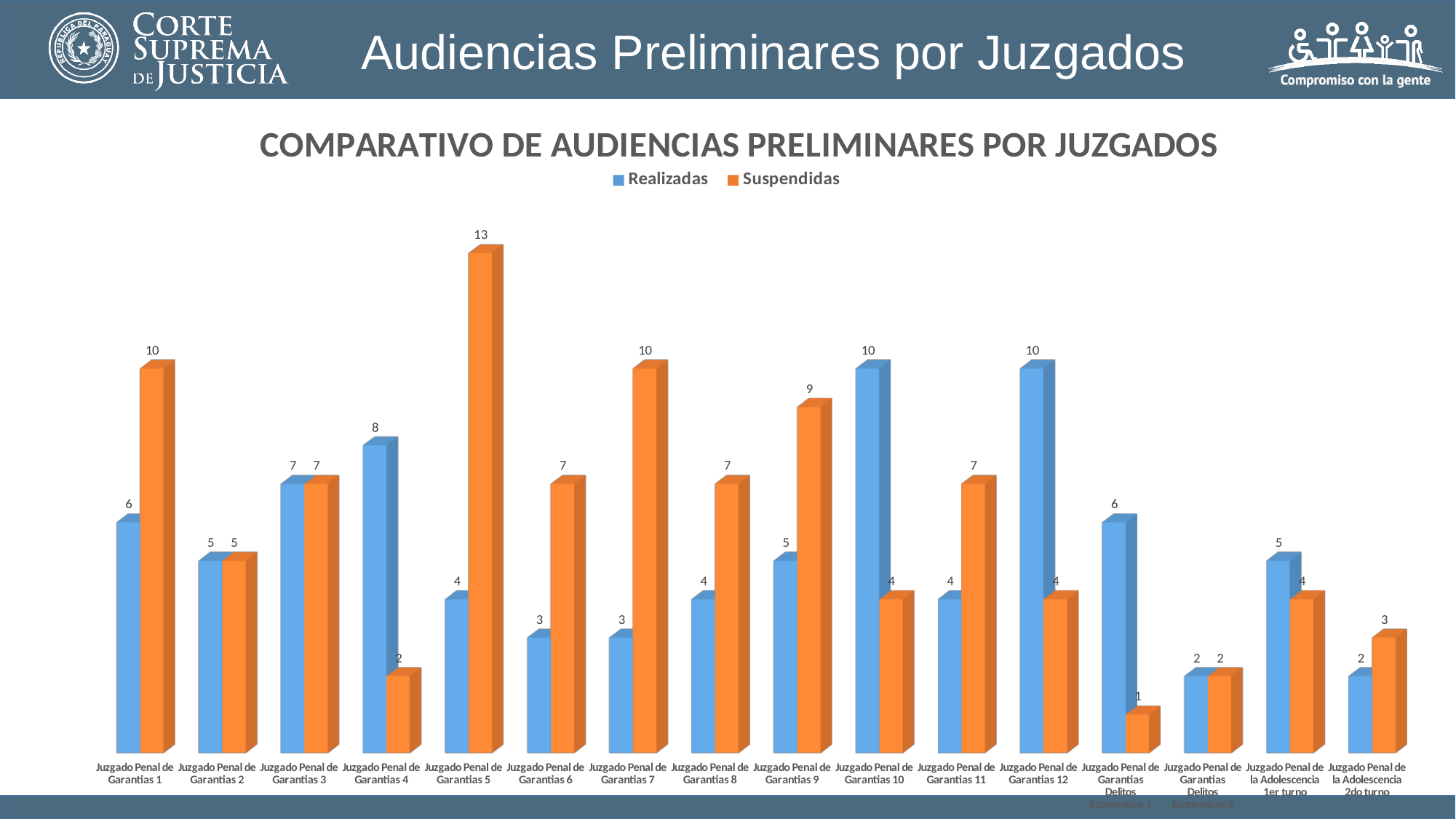
What is the title of the chart? COMPARATIVO DE AUDIENCIAS PRELIMINARES POR JUZGADOS Which juzgado has the lowest Suspendidas value? Juzgado Penal de Garantias Delitos Economicos 1 What is the Realizadas value for Juzgado Penal de Garantias 4? 8 What is the Suspendidas value for Juzgado Penal de Garantias 9? 9 For Juzgado Penal de Garantias 10, which is larger, Realizadas or Suspendidas? Realizadas Which juzgado has the highest Suspendidas value? Juzgado Penal de Garantias 5 For Juzgado Penal de Garantias 1, which is larger, Realizadas or Suspendidas? Suspendidas How many series does the legend list? 2 How many juzgados (categories) are shown on the chart? 16 What is the difference between Suspendidas and Realizadas for Juzgado Penal de Garantias 7? 7 What is the Suspendidas value for Juzgado Penal de Garantias 5? 13 What kind of chart is shown on the slide? Bar chart